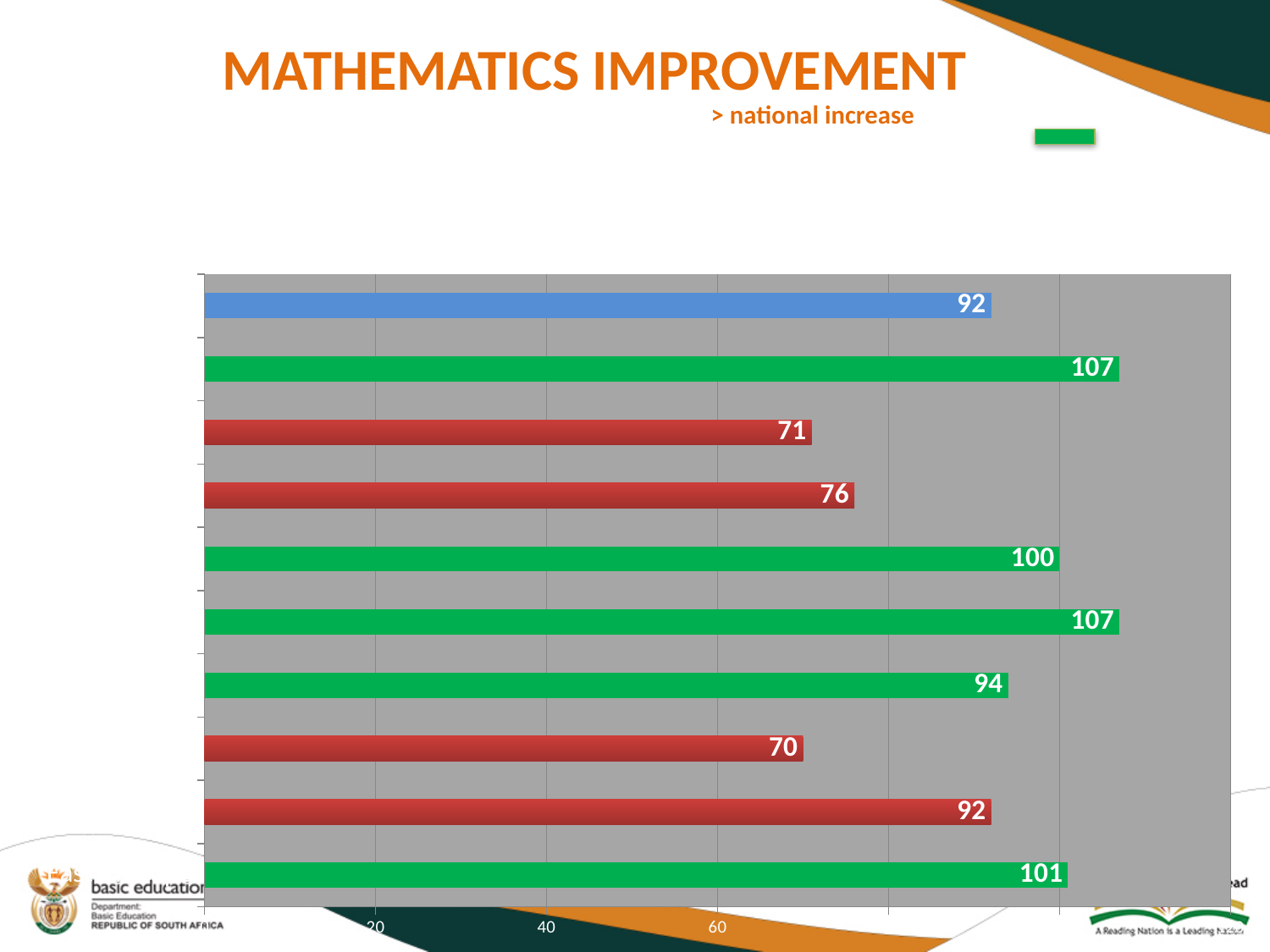
What kind of chart is shown on the slide? bar chart What is the value of the topmost (blue) bar? 92 What is the title of the chart on the slide? MATHEMATICS IMPROVEMENT How many bars in the chart are coloured red? 4 Which is larger: the second bar from the top or the third bar from the top? the second bar from the top Is the value of the fourth bar from the top greater or less than 60? greater What is the highest value shown on any bar in the chart? 107 What is the value of the bottom bar in the chart? 101 What is the difference between the value of the top bar (92) and the third bar from the top (71)? 21 How many bars are plotted in the chart? 10 What is the value of the third bar from the top? 71 What is the lowest value shown on any bar in the chart? 70